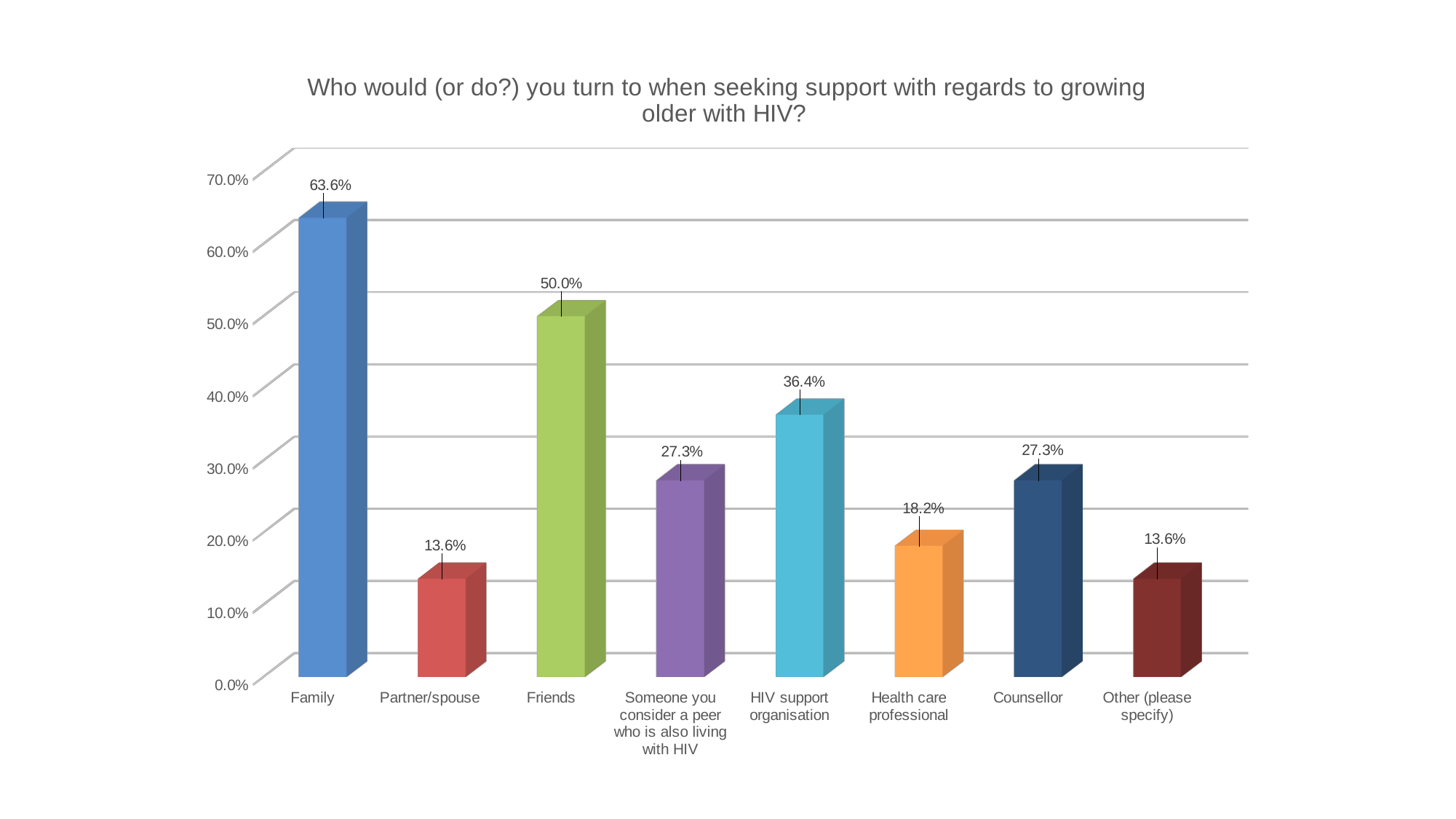
Which two categories both have a value of 27.3%? Someone you consider a peer who is also living with HIV and Counsellor What is the difference between the values for HIV support organisation and Counsellor? 9.1% What is the difference between the values for Family and Friends? 13.6% What is the value for Family? 63.6% What is the value for HIV support organisation? 36.4% Is the value for Partner/spouse greater or less than 20.0%? less What is the value for Health care professional? 18.2% What kind of chart is shown on the slide? bar chart How many categories are shown on the x axis? 8 Which is larger, the value for Friends or the value for HIV support organisation? Friends What is the title of the chart? Who would (or do?) you turn to when seeking support with regards to growing older with HIV? Which category has the highest value? Family